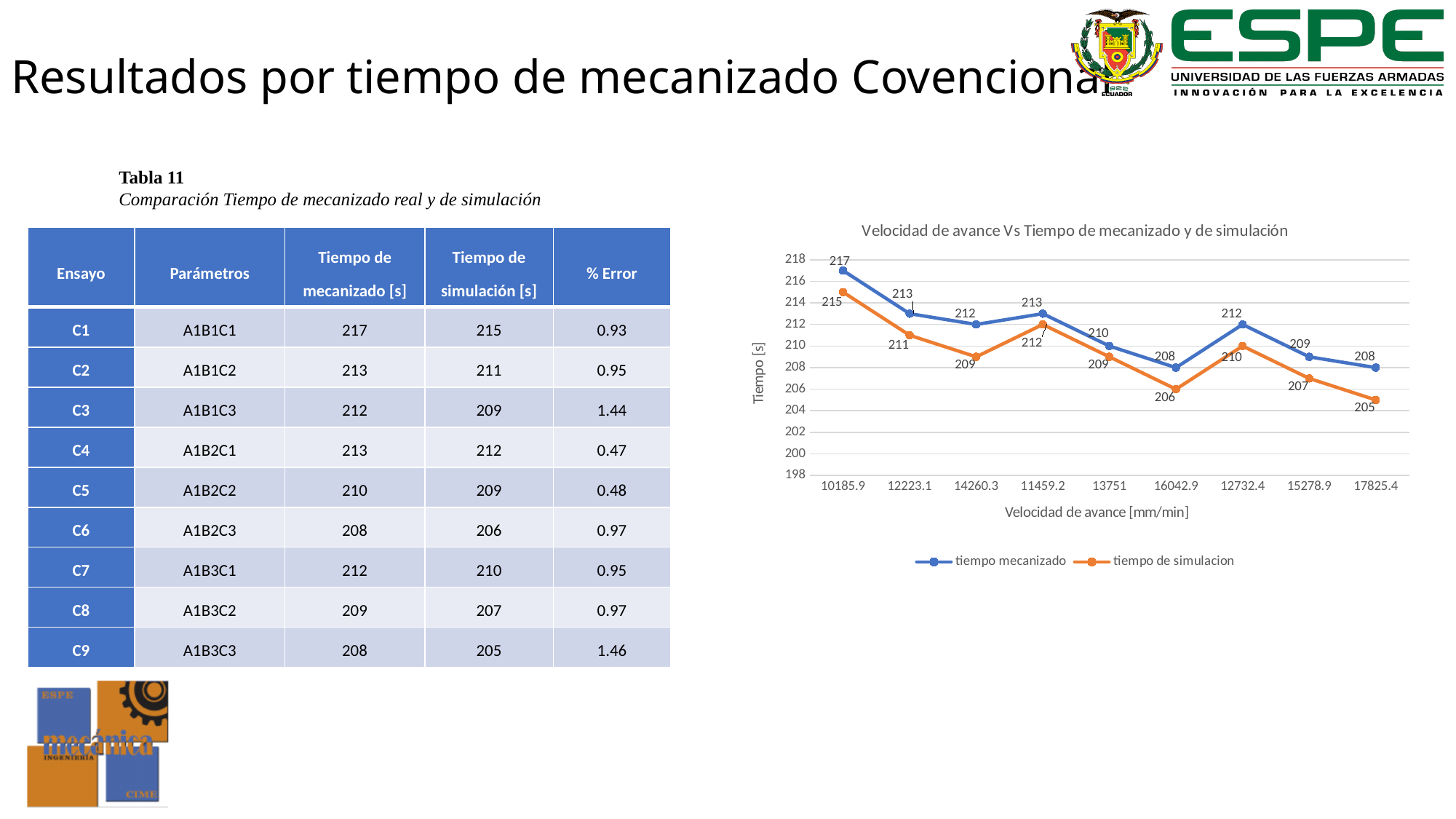
What is the tiempo de simulacion value at a feed rate of 16042.9 mm/min? 206 How many x-axis categories (feed rates) are plotted in the chart? 9 At which feed rate is the tiempo de simulacion lowest? 17825.4 What is the difference between tiempo mecanizado and tiempo de simulacion at a feed rate of 14260.3 mm/min? 3 What type of chart is shown on the slide? line chart At which feed rate is the tiempo mecanizado highest? 10185.9 What is the tiempo mecanizado value at a feed rate of 10185.9 mm/min? 217 Is the tiempo de simulacion value at 11459.2 mm/min greater or less than 210? greater How many series does the chart legend list? 2 Which is larger at a feed rate of 12732.4 mm/min: tiempo mecanizado or tiempo de simulacion? tiempo mecanizado What is the title of the chart? Velocidad de avance Vs Tiempo de mecanizado y de simulación What is the tiempo de simulacion value at a feed rate of 17825.4 mm/min? 205